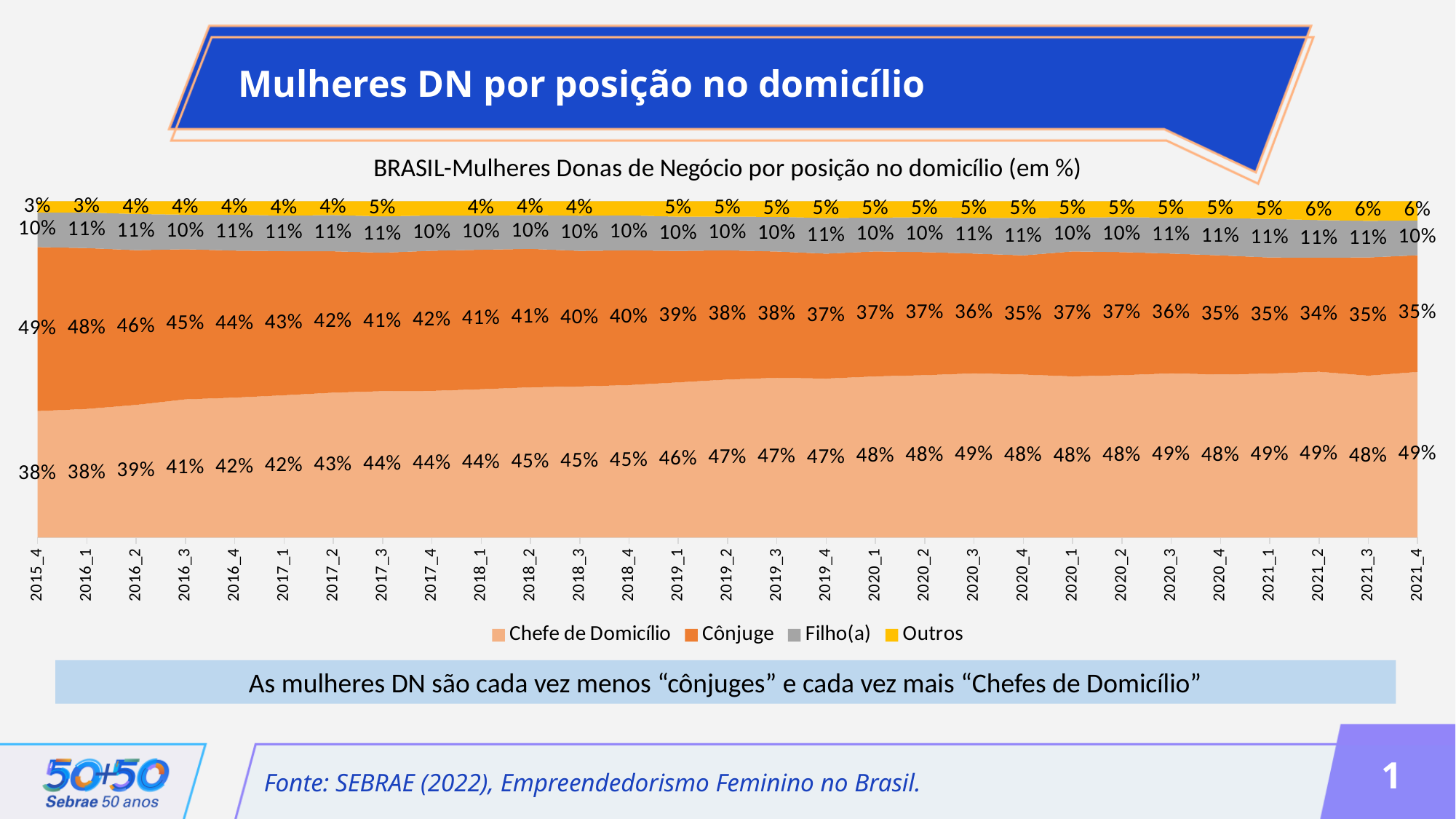
By how many percentage points did Chefe de Domicílio change between 2015_4 and 2021_4? 11 percentage points What is the value for Chefe de Domicílio at 2021_4? 49% What is the value for Chefe de Domicílio at 2015_4? 38% At 2021_4, which is larger: Chefe de Domicílio or Cônjuge? Chefe de Domicílio What is the value for Cônjuge at 2021_4? 35% What is the title of the chart? BRASIL-Mulheres Donas de Negócio por posição no domicílio (em %) What is the value for Cônjuge at 2015_4? 49% Does the Chefe de Domicílio series rise or fall from 2015_4 to 2021_4? Rise What kind of chart is shown on the slide? Stacked area chart What is the value for Outros at 2021_4? 6% Does the Cônjuge series rise or fall from 2015_4 to 2021_4? Fall How many series does the legend list? 4